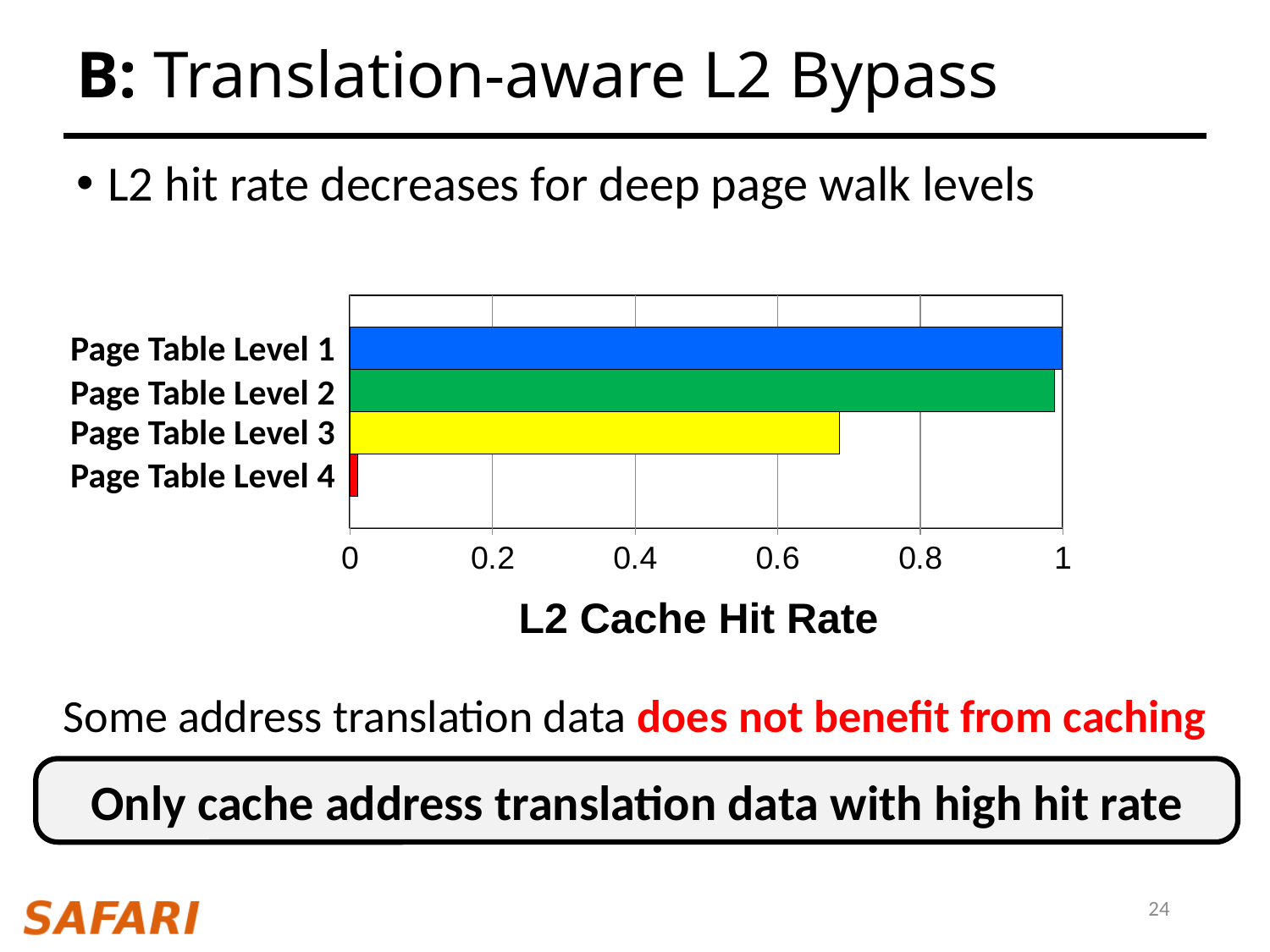
How many page table levels are plotted in the chart? 4 What colour is the bar for Page Table Level 4? red Which has a higher L2 cache hit rate, Page Table Level 3 or Page Table Level 4? Page Table Level 3 Is the L2 cache hit rate for Page Table Level 4 greater or less than 0.2? less Is the L2 cache hit rate for Page Table Level 2 greater or less than 0.8? greater Is the L2 cache hit rate for Page Table Level 3 greater or less than 0.6? greater What is the title of the horizontal axis of the chart? L2 Cache Hit Rate Which has a higher L2 cache hit rate, Page Table Level 2 or Page Table Level 3? Page Table Level 2 Which page table level has the lowest L2 cache hit rate? Page Table Level 4 Does the L2 cache hit rate rise or fall as the page table level goes from Level 1 to Level 4? fall What kind of chart is shown on the slide? bar chart